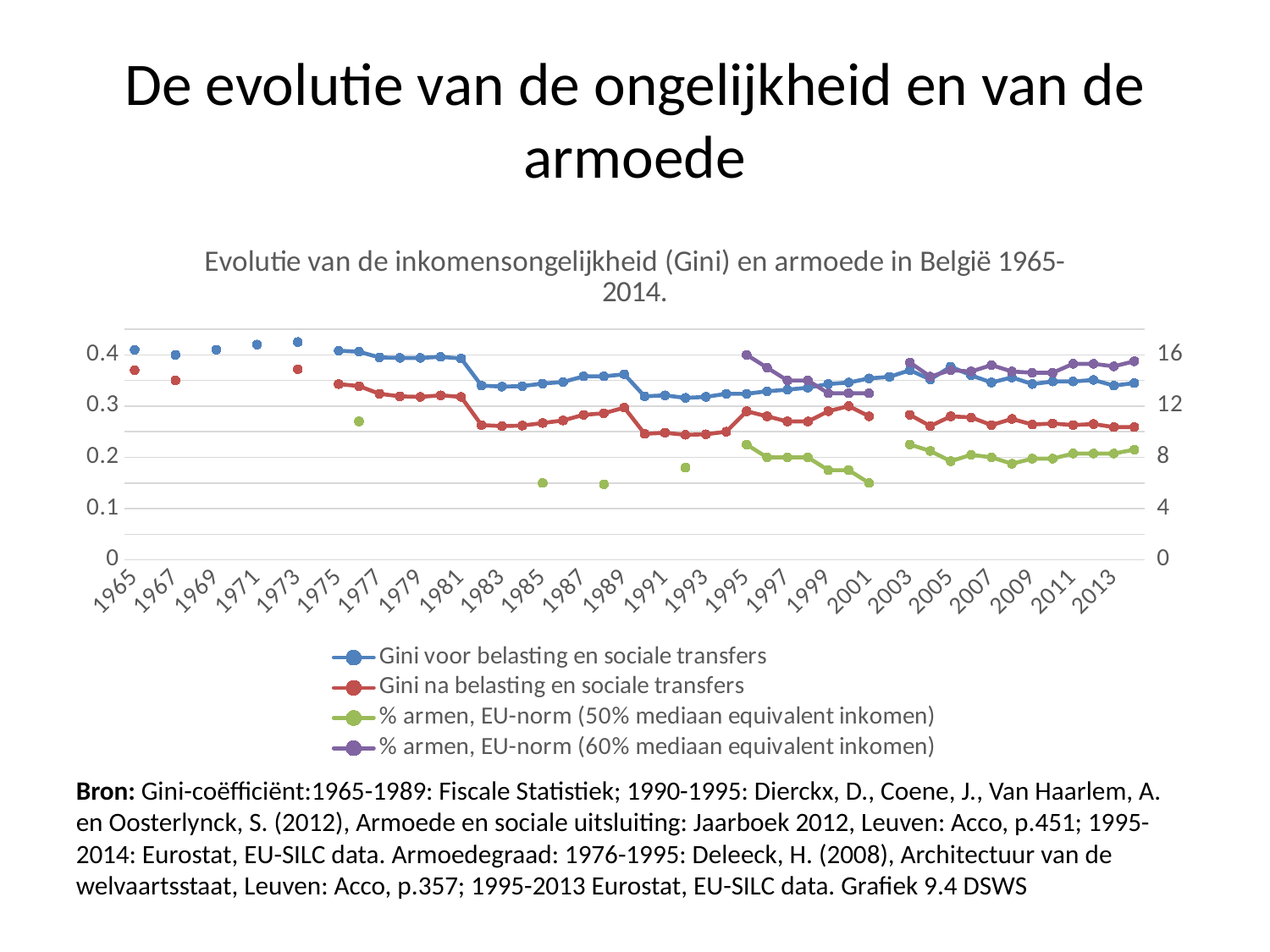
Is the value for 'Gini voor belasting en sociale transfers' in 1965 greater or less than 0.3? greater Which colour is used for the series 'Gini voor belasting en sociale transfers'? blue In 1975, which is larger: 'Gini voor belasting en sociale transfers' or 'Gini na belasting en sociale transfers'? Gini voor belasting en sociale transfers What kind of chart is shown on the slide? line chart Is the value for '% armen, EU-norm (50% mediaan equivalent inkomen)' in 1985 greater or less than 8 on the right axis? less What is the title of the chart? Evolutie van de inkomensongelijkheid (Gini) en armoede in België 1965-2014. Does the value for '% armen, EU-norm (60% mediaan equivalent inkomen)' rise or fall between 1995 and 2001? fall Is the value for 'Gini na belasting en sociale transfers' in 1983 greater or less than 0.3? less In 2013, which is larger: '% armen, EU-norm (60% mediaan equivalent inkomen)' or '% armen, EU-norm (50% mediaan equivalent inkomen)'? % armen, EU-norm (60% mediaan equivalent inkomen) How many series does the legend list? 4 Does the value for 'Gini na belasting en sociale transfers' rise or fall between 1975 and 1983? fall